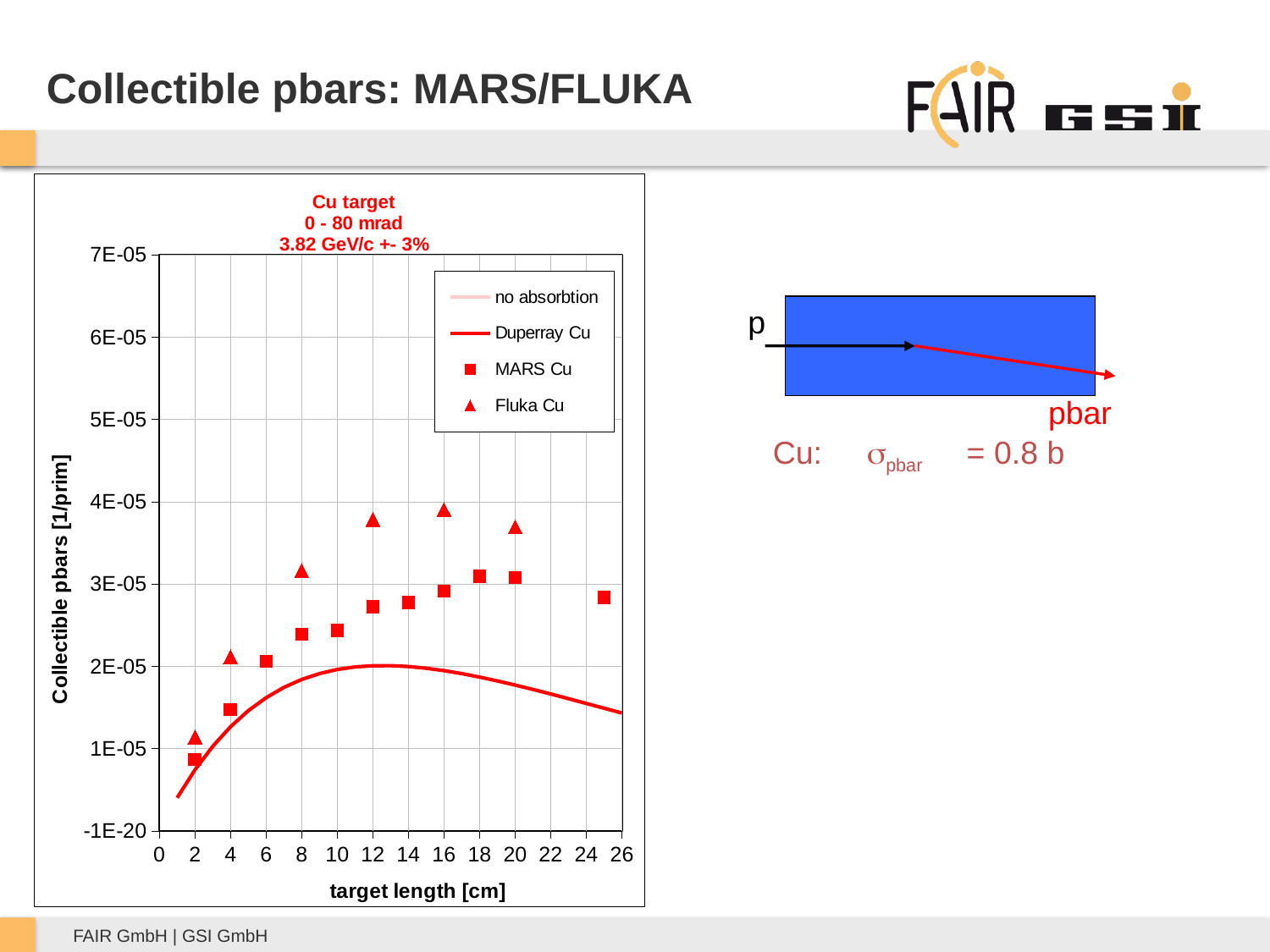
Does the Duperray Cu curve rise or fall between a target length of 14 cm and 26 cm? fall At which target length is the MARS Cu value lowest? 2 cm How many Fluka Cu data points are plotted on the chart? 6 At a target length of 16 cm, which is larger: the Fluka Cu value or the MARS Cu value? Fluka Cu What is the label of the x axis of the chart? target length [cm] Is the highest point of the Duperray Cu curve greater or less than 3E-05? less What kind of chart is shown on the slide? scatter chart Is the Fluka Cu value at a target length of 16 cm greater or less than 3E-05? greater Is the MARS Cu value at a target length of 12 cm greater or less than 3E-05? less What is the label of the y axis of the chart? Collectible pbars [1/prim] How many series does the legend of the chart list? 4